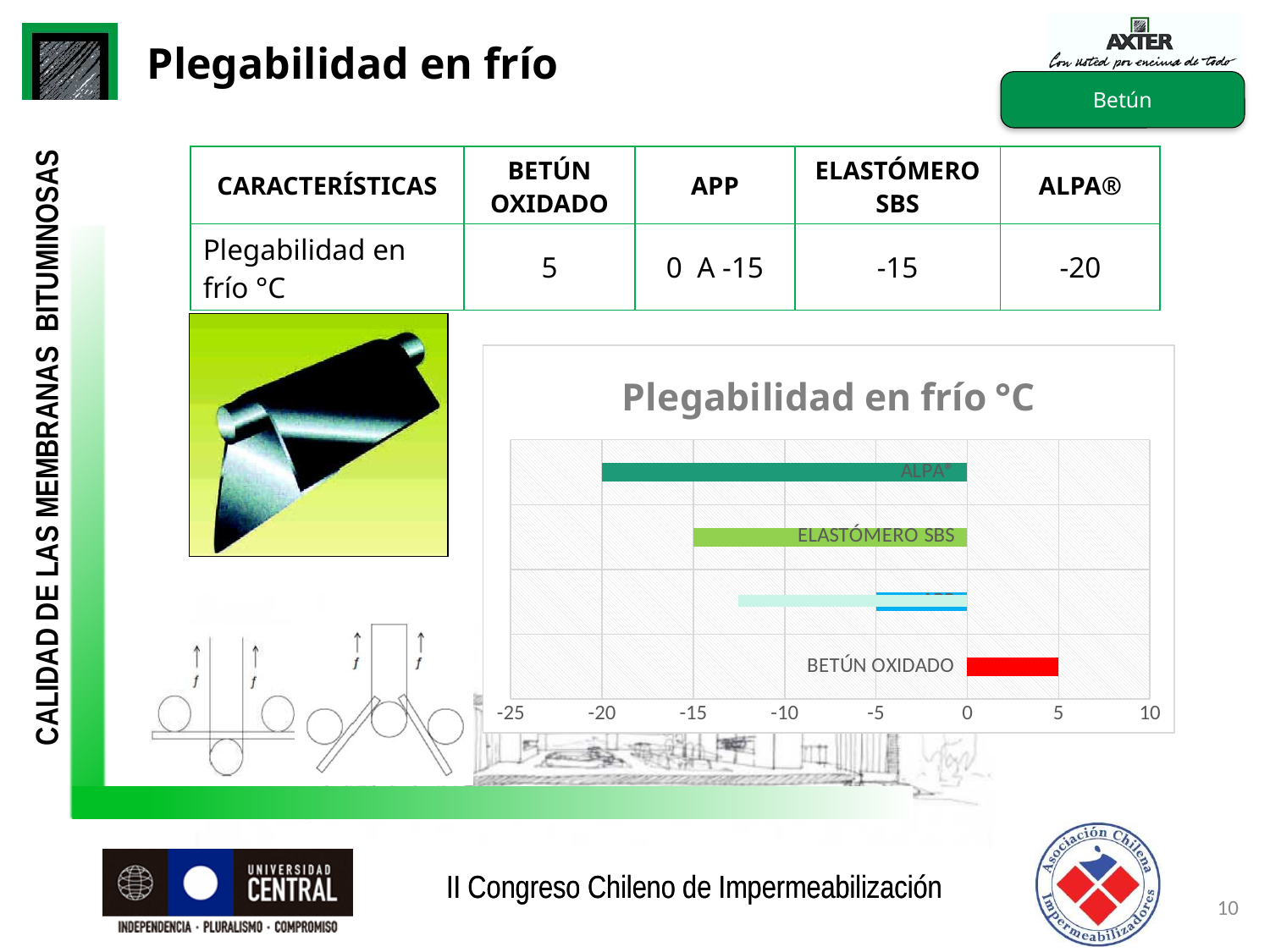
What is the value for BETÚN OXIDADO in the chart? 5 Which category has the highest value in the chart? BETÚN OXIDADO What is the difference between the value for ELASTÓMERO SBS and the value for ALPA®? 5 Which category has the lowest value in the chart? ALPA® What kind of chart is shown on the slide? bar chart Which is larger, the value for ALPA® or the value for ELASTÓMERO SBS? ELASTÓMERO SBS Is the value for BETÚN OXIDADO greater or less than 0? greater What is the value for ALPA® in the chart? -20 What is the title of the chart? Plegabilidad en frío °C What is the lowest value shown on the horizontal axis of the chart? -25 What is the difference between the value for BETÚN OXIDADO and the value for ALPA®? 25 What is the value for ELASTÓMERO SBS in the chart? -15